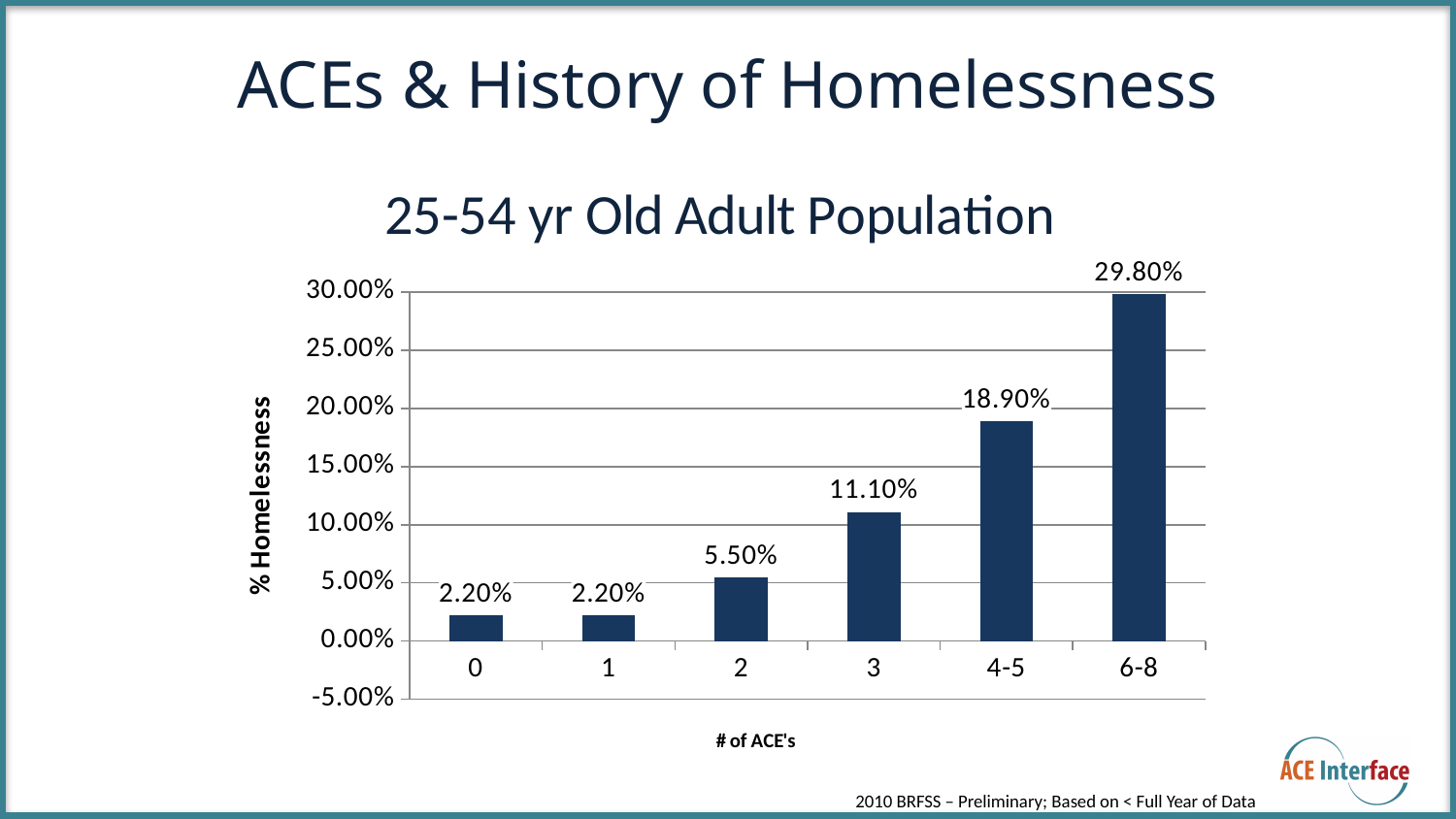
What is the % Homelessness for the 4-5 ACEs category? 18.90% What is the difference in % Homelessness between the 6-8 and 4-5 ACEs categories? 10.90% Which # of ACE's category has the highest % Homelessness? 6-8 What is the % Homelessness for 0 ACEs? 2.20% What is the title of the chart? 25-54 yr Old Adult Population What is the difference in % Homelessness between 2 ACEs and 1 ACE? 3.30% Does % Homelessness rise or fall as the # of ACE's increases along the x axis? rise Is the % Homelessness for 6-8 ACEs greater or less than 25.00%? greater Which has a higher % Homelessness, 3 ACEs or 2 ACEs? 3 What type of chart is shown on the slide? bar chart How many # of ACE's categories are shown on the x axis? 6 What is the % Homelessness for 3 ACEs? 11.10%